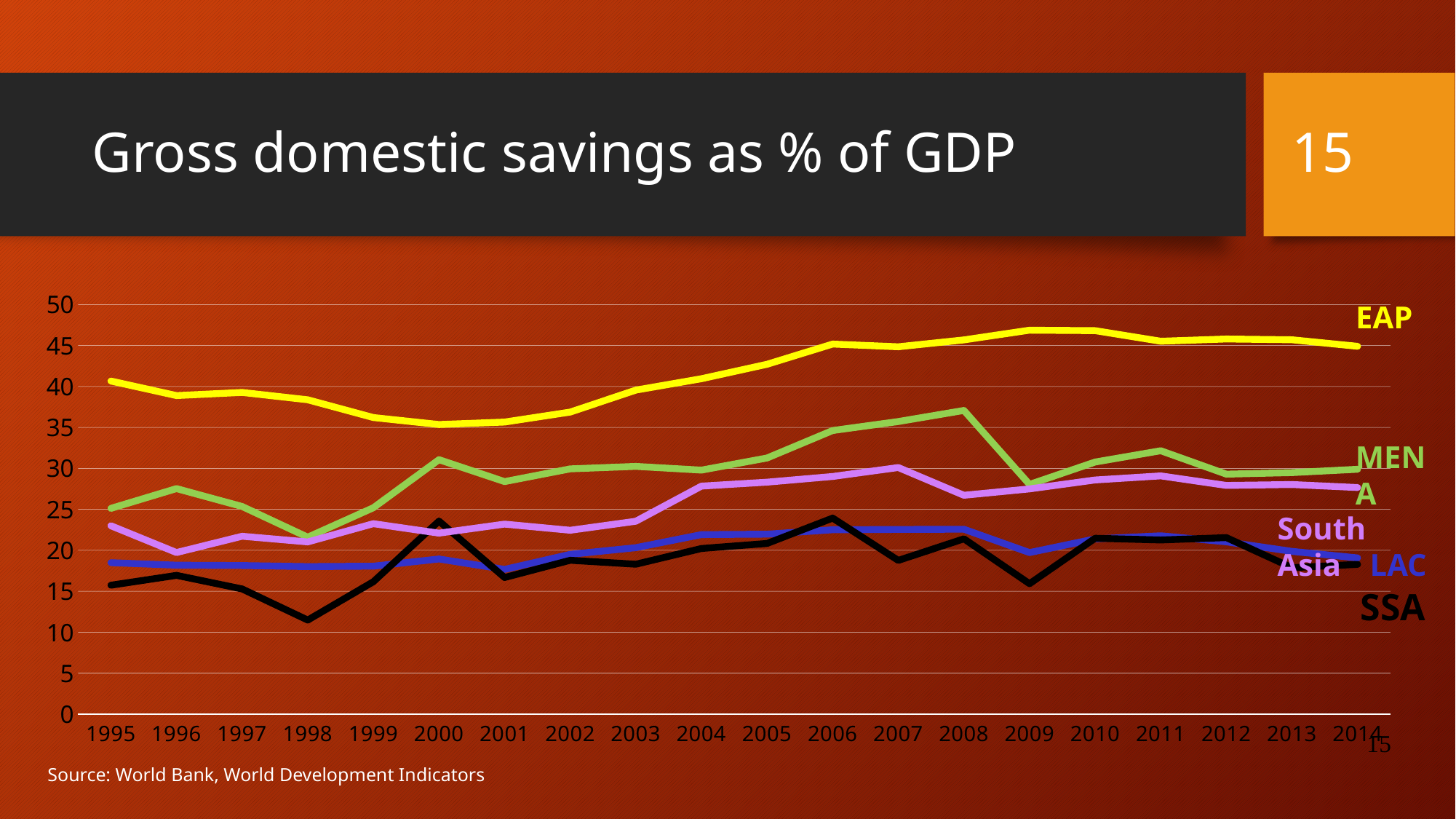
How many series (regions) are plotted on the chart? 5 Does the EAP line rise or fall between 2000 and 2006? rise Is the value for MENA in 2008 greater or less than 35? greater Is the value for EAP in 2000 greater or less than 40? less How many years are shown along the x axis? 20 What is the title of the chart? Gross domestic savings as % of GDP Which region has the lowest gross domestic savings as % of GDP in 1998? SSA Which region has the highest gross domestic savings as % of GDP in 2014? EAP What kind of chart is shown on the slide? line chart Is the value for South Asia in 1996 greater or less than 25? less In 1998, which is larger: the value for LAC or the value for SSA? LAC